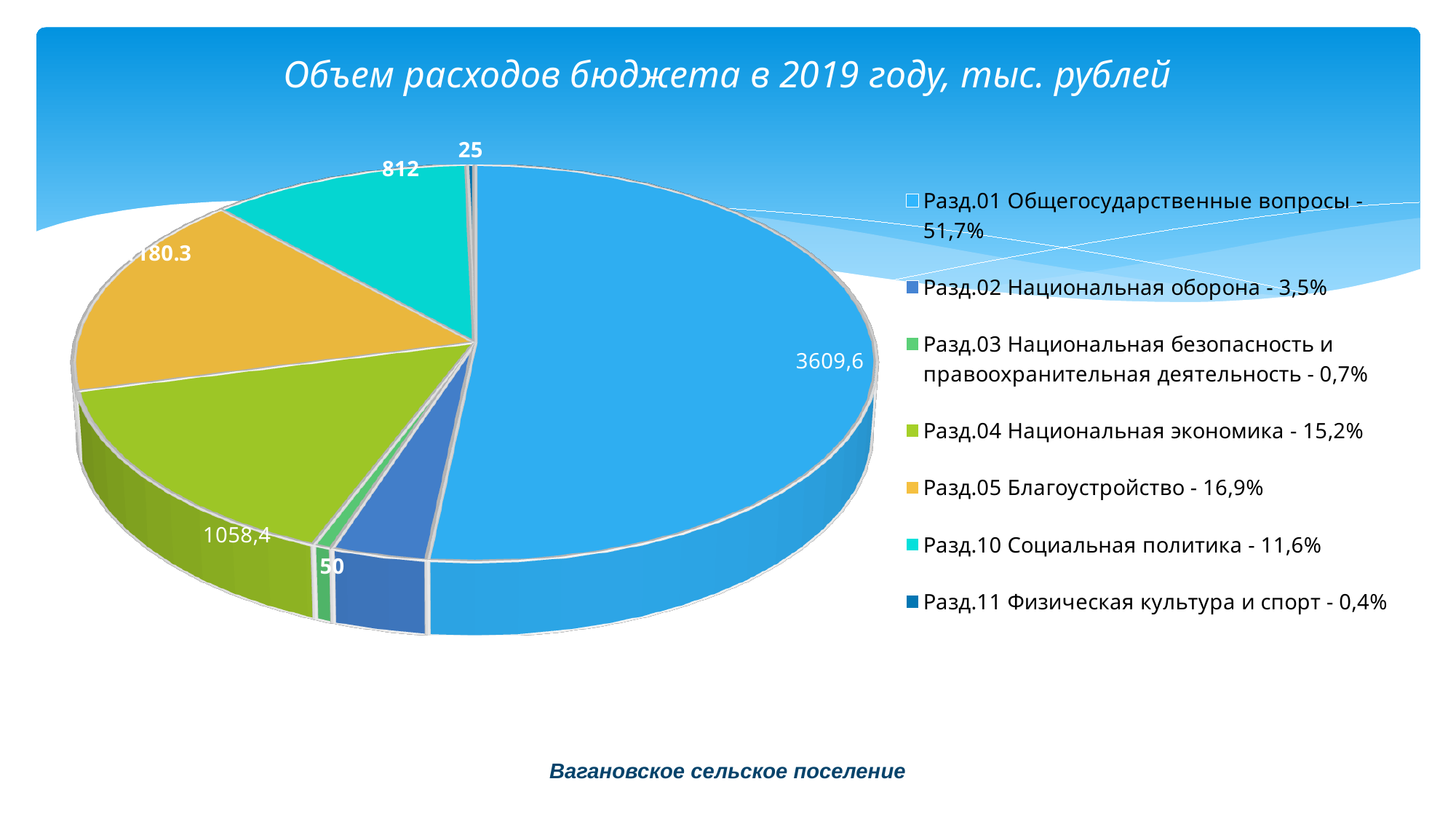
What is the value for Разд.01 Общегосударственные вопросы? 3609,6 Which is larger, the value for Разд.10 Социальная политика or Разд.04 Национальная экономика? Разд.04 Национальная экономика What is the difference between the values for Разд.01 Общегосударственные вопросы and Разд.04 Национальная экономика? 2551,2 What is the value for Разд.04 Национальная экономика? 1058,4 Which category has the largest slice of the pie? Разд.01 Общегосударственные вопросы What is the title of the chart? Объем расходов бюджета в 2019 году, тыс. рублей How many categories does the legend list? 7 Which category has the smallest slice of the pie? Разд.11 Физическая культура и спорт What share of the pie does Разд.05 Благоустройство represent? 16,9% What kind of chart is shown on the slide? pie chart What is the value for Разд.11 Физическая культура и спорт? 25 What is the value for Разд.10 Социальная политика? 812